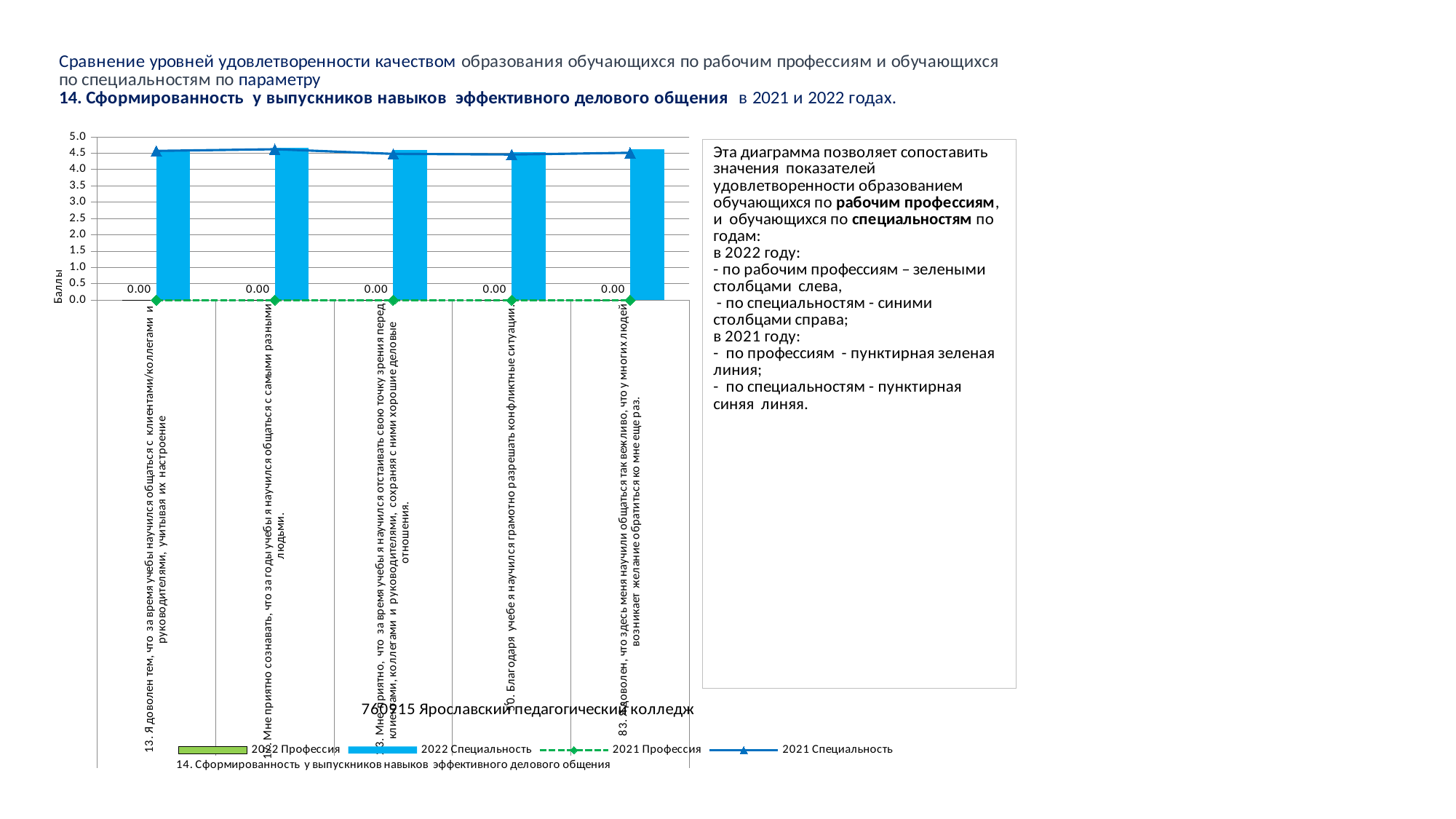
Is the 2022 Специальность value for the last category (83. ...) greater or less than 3.0? greater Does the 2021 Профессия line rise, fall or stay flat across the categories? stays flat How many series does the chart legend list? 4 What is the value of the 2022 Профессия series for the last category (83. Я доволен, что здесь меня научили общаться так вежливо...)? 0.00 What is the value of the 2022 Профессия series for the first category (13. Я доволен тем, что за время учебы научился общаться с клиентами/коллегами и руководителями...)? 0.00 Is the 2021 Специальность value for the last category (83. ...) greater or less than 4.0? greater What kind of chart is shown on the slide? bar chart (with line series) How many categories are plotted along the x axis of the chart? 5 Is the 2022 Специальность value for the first category (13. ...) greater or less than 4.0? greater What is the highest value shown on the vertical axis of the chart? 5.0 What colour are the bars for the 2022 Специальность series? blue What is the title of the vertical axis of the chart? Баллы